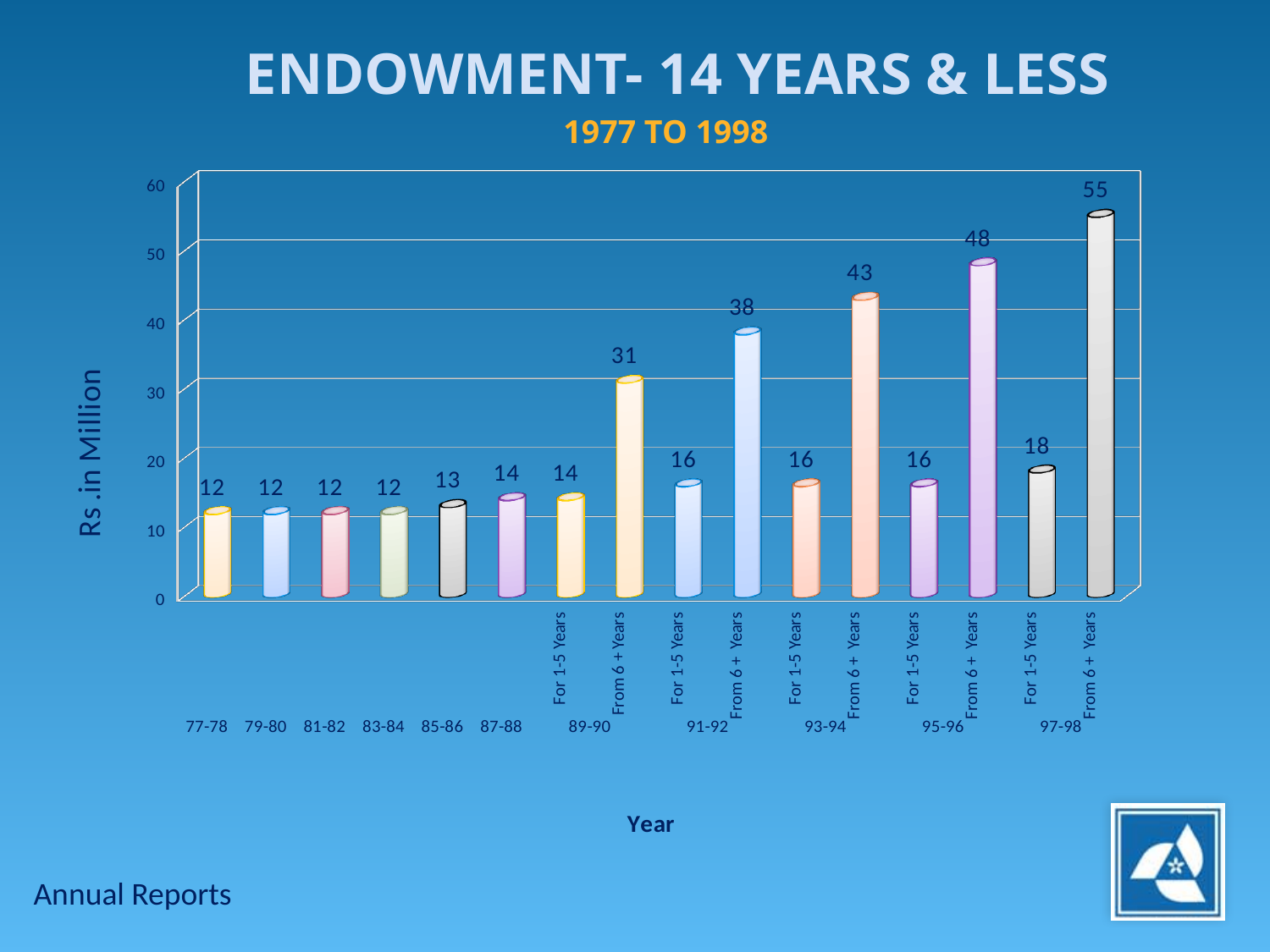
What is the value for 'For 1-5 Years' in 97-98? 18 What is the label of the vertical axis? Rs .in Million What type of chart is shown on the slide? Bar chart What is the value for 85-86? 13 What is the difference between the 'From 6 + Years' and 'For 1-5 Years' values in 95-96? 32 Do the 'From 6 + Years' values rise or fall from 89-90 to 97-98? Rise Which bar has the highest value? From 6 + Years, 97-98 (55) What is the value for 'From 6 + Years' in 93-94? 43 Which is larger: the value for 87-88 or the value for 'For 1-5 Years' in 91-92? For 1-5 Years in 91-92 Is the value for 'From 6 + Years' in 95-96 greater or less than 40? greater What is the difference between the 'From 6 + Years' values for 91-92 and 89-90? 7 How many bars are plotted in the chart? 16